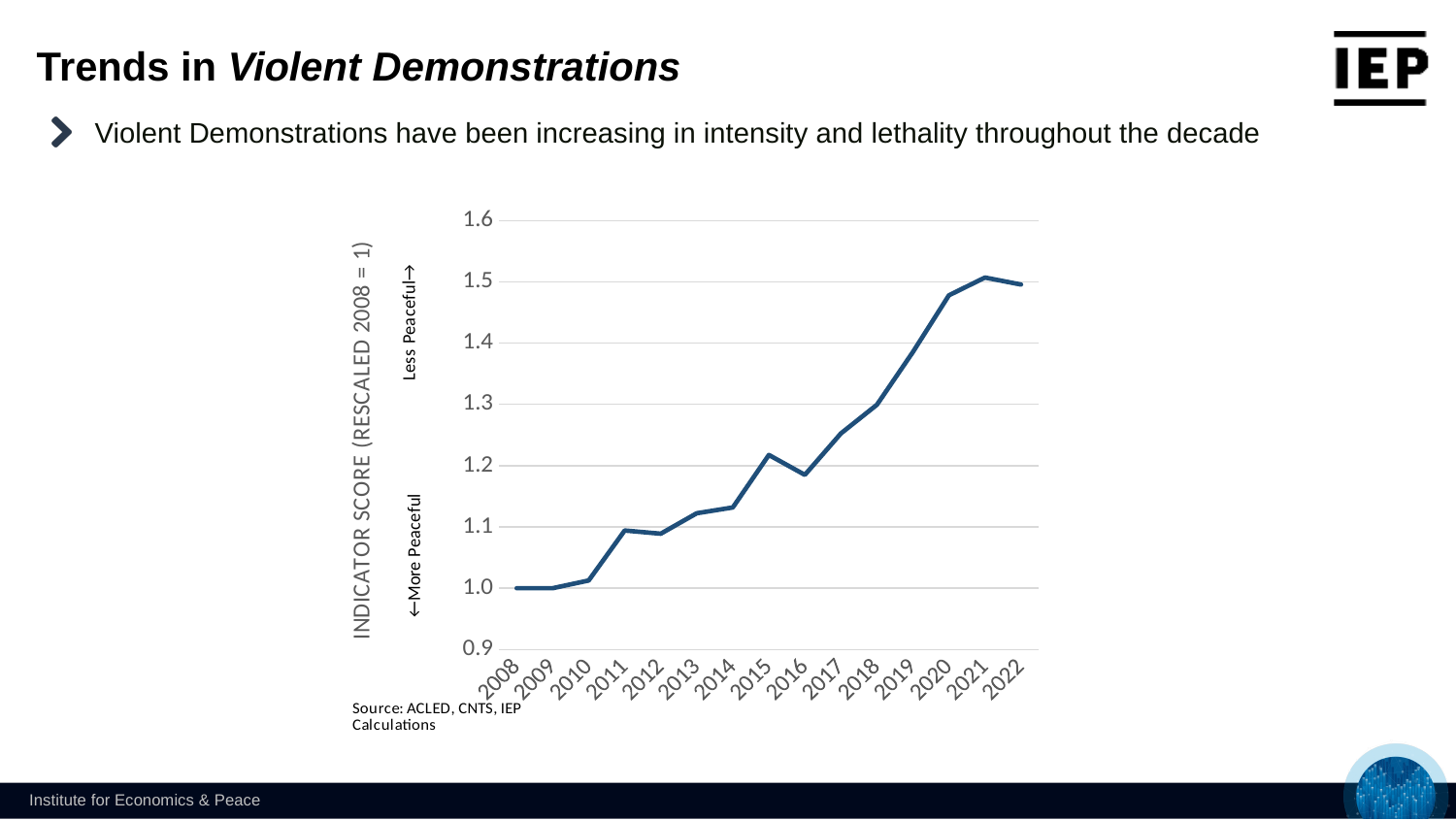
Is the value for 2015 greater or less than 1.1? greater Is the value for 2021 greater or less than 1.4? greater How many years are plotted along the x axis of the chart? 15 Do the values generally rise or fall from 2008 to 2022? rise Is the value for 2019 greater or less than 1.3? greater What is the y-axis title of the chart? INDICATOR SCORE (RESCALED 2008 = 1) What is the indicator score for 2008? 1.0 What kind of chart is shown on the slide? line chart Which year has the larger value, 2020 or 2012? 2020 What source is cited below the chart? ACLED, CNTS, IEP Calculations